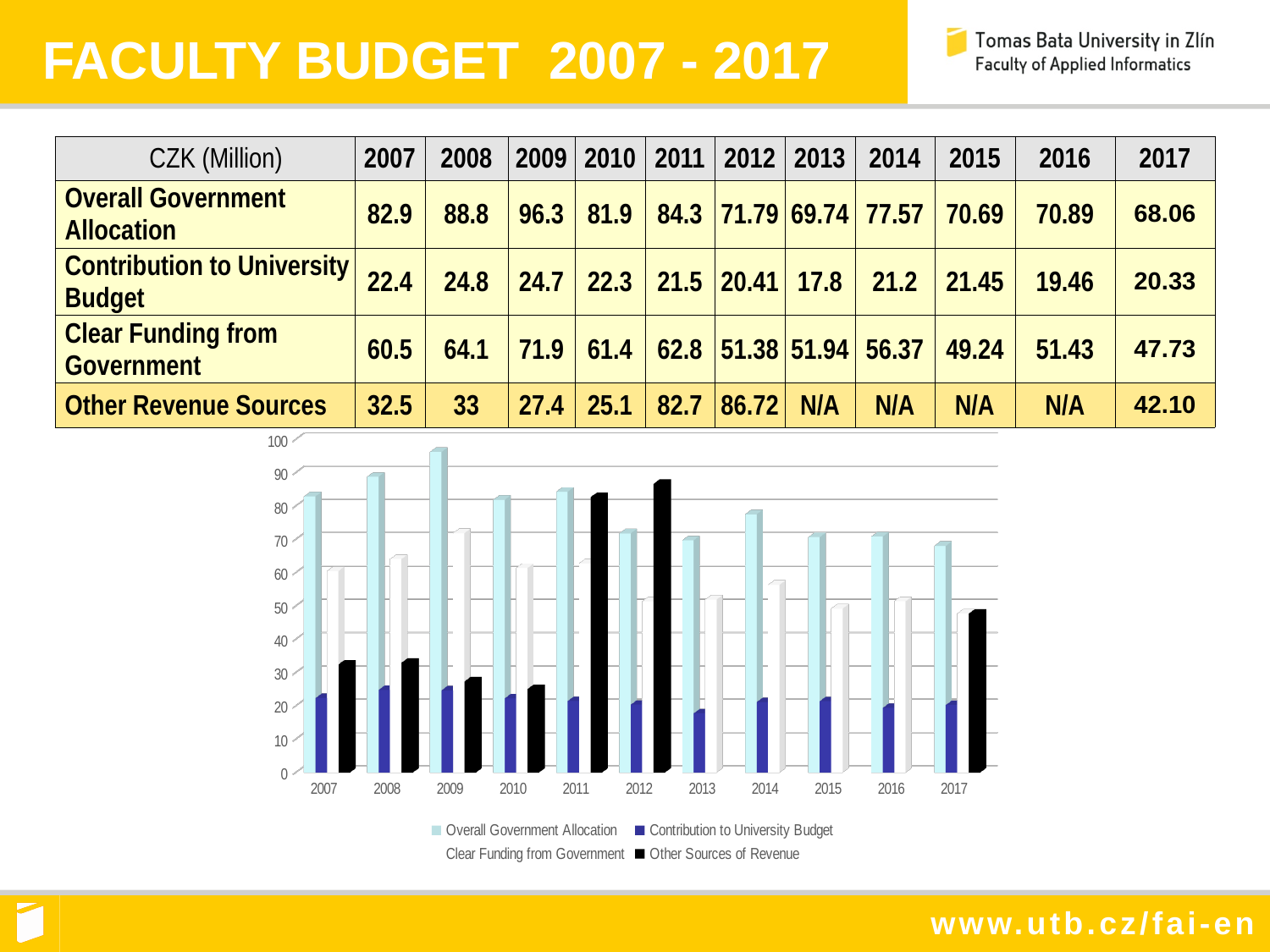
How many years are shown along the x axis of the chart? 11 What kind of chart is shown on the slide? Bar chart How many series does the chart legend list? 4 By how much did the Overall Government Allocation increase from 2007 to 2008? 5.9 What is the Clear Funding from Government value for 2014? 56.37 What colour are the Other Sources of Revenue bars in the chart? Black Is the Overall Government Allocation bar for 2009 greater or less than 90? greater Which year has the larger Other Sources of Revenue value, 2011 or 2012? 2012 What is the Contribution to University Budget value for 2013? 17.8 In which year is the Overall Government Allocation highest? 2009 In which year is the Overall Government Allocation lowest? 2017 Does the Clear Funding from Government rise or fall from 2007 to 2009? rise